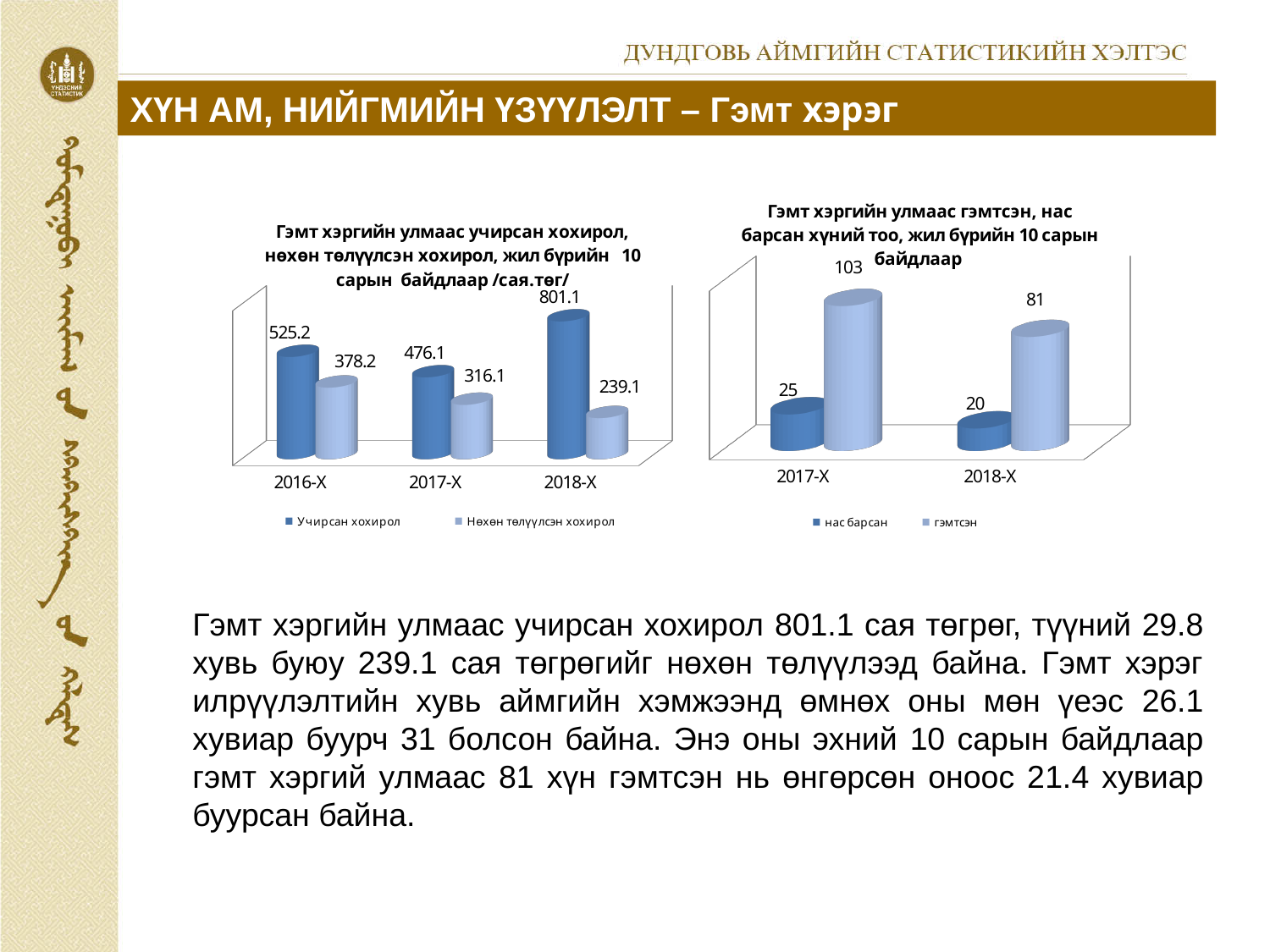
In the left chart, what is the difference between Учирсан хохирол and Нөхөн төлүүлсэн хохирол for 2017-X? 160.0 In the left chart, what is the value of Учирсан хохирол for 2018-X? 801.1 In the right chart, what is the difference between гэмтсэн in 2017-X and 2018-X? 22 In the right chart, what is the value of гэмтсэн for 2017-X? 103 In the left chart, does Нөхөн төлүүлсэн хохирол rise or fall from 2016-X to 2018-X? fall In the right chart, which is larger: нас барсан for 2017-X or нас барсан for 2018-X? 2017-X How many series does the legend of the left chart list? 2 In the left chart, which year has the highest value for Учирсан хохирол? 2018-X In the right chart, what is the value of нас барсан for 2018-X? 20 In the left chart, which year has the lowest value for Нөхөн төлүүлсэн хохирол? 2018-X In the left chart, what is the value of Нөхөн төлүүлсэн хохирол for 2016-X? 378.2 What kind of chart is the right chart? bar chart